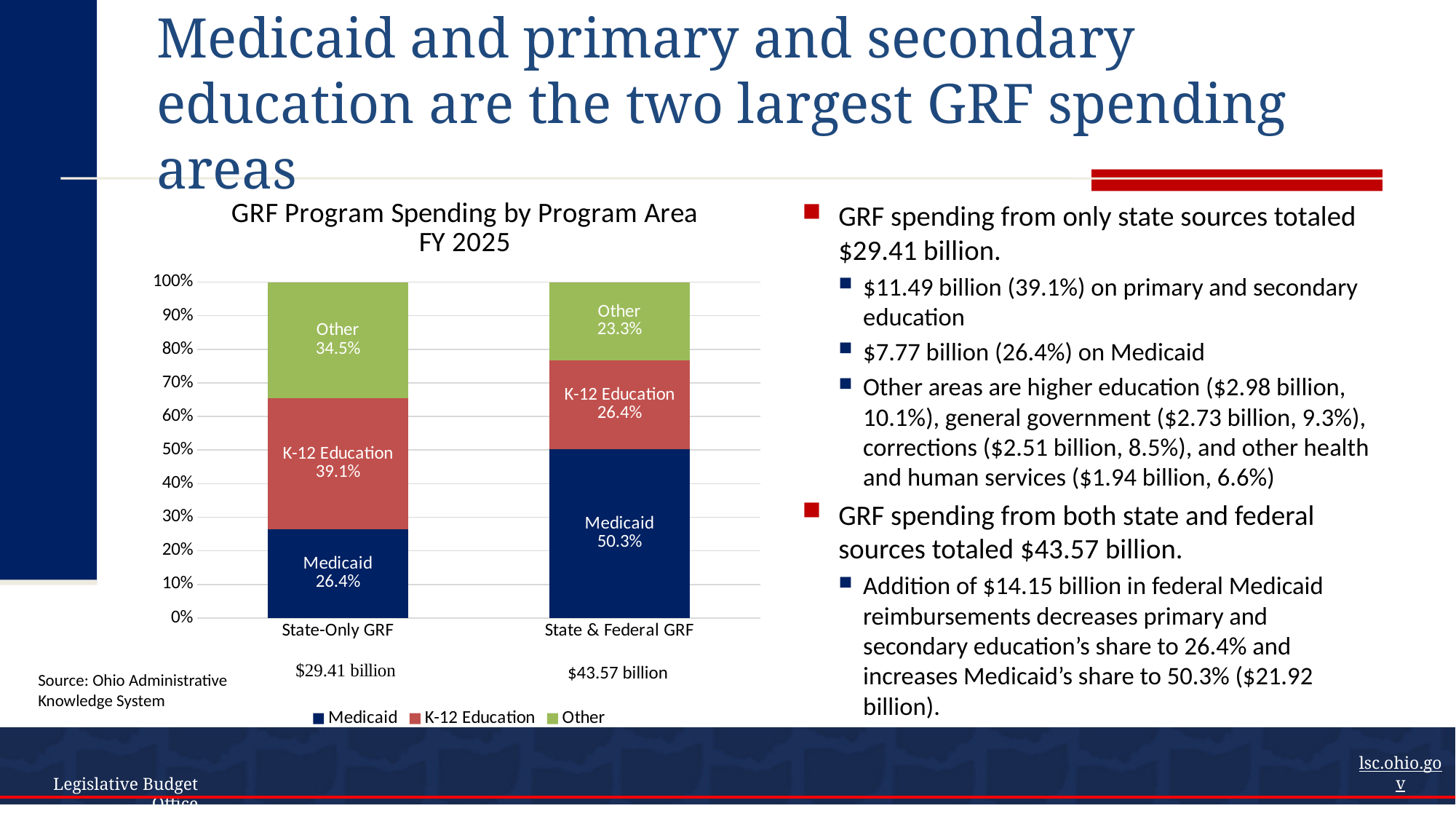
What is the Medicaid share for State & Federal GRF? 50.3% How many bars (categories) are shown on the chart? 2 Which program area has the smallest share in the State & Federal GRF bar? Other What is the K-12 Education share for State & Federal GRF? 26.4% What is the title of the chart? GRF Program Spending by Program Area FY 2025 Which is larger: the Other share for State-Only GRF or the Other share for State & Federal GRF? State-Only GRF What is the Medicaid share for State-Only GRF? 26.4% What kind of chart is shown on the slide? Stacked bar chart Which program area has the largest share in the State-Only GRF bar? K-12 Education What is the Other share for State-Only GRF? 34.5% What is the difference between the Medicaid share for State & Federal GRF and the Medicaid share for State-Only GRF? 23.9% How many series does the legend list? 3